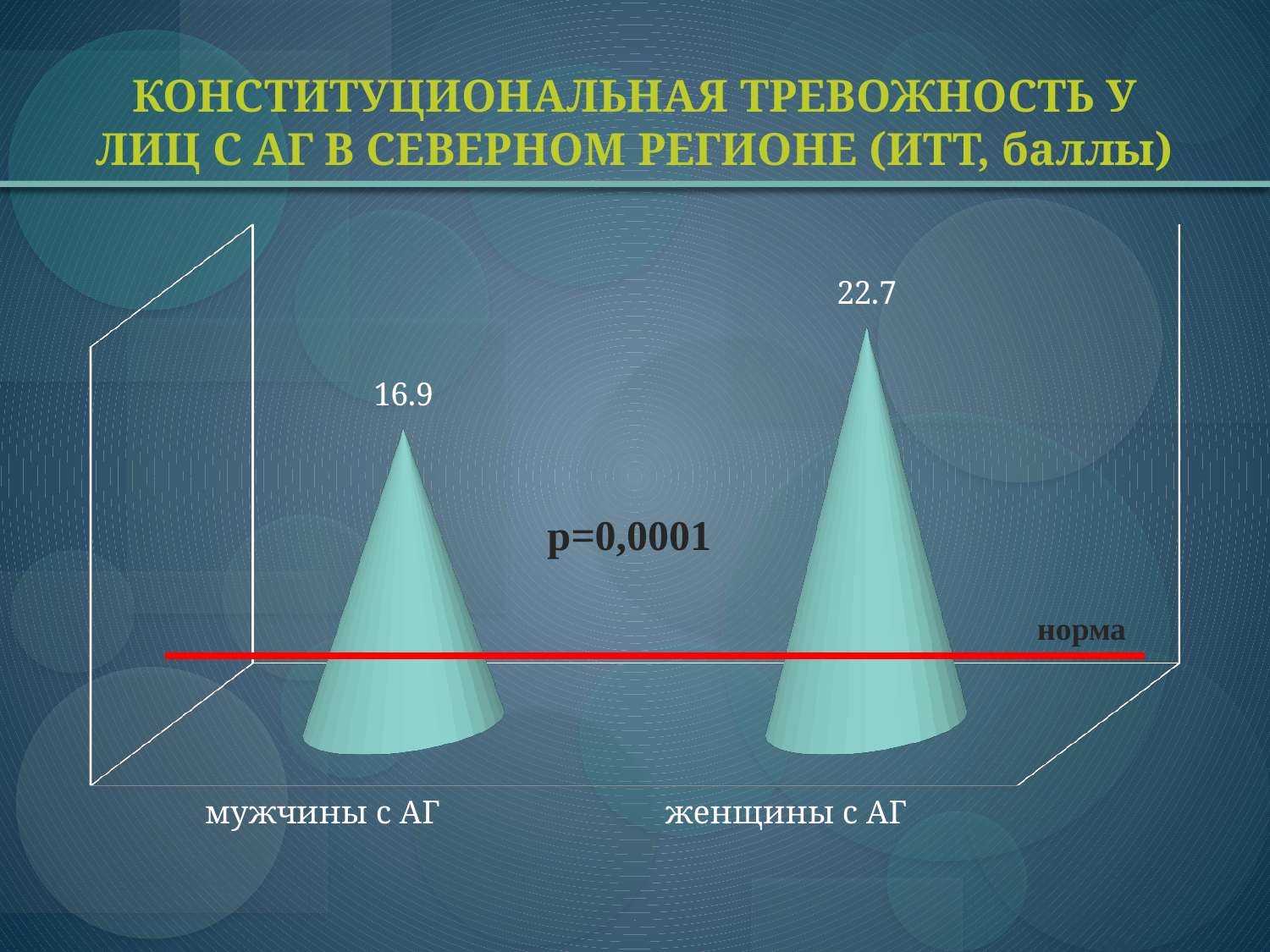
What is the p-value printed on the chart? p=0,0001 Which category has the lowest value? мужчины с АГ What is the value for женщины с АГ? 22.7 Which is larger, the value for мужчины с АГ or the value for женщины с АГ? женщины с АГ What does the red horizontal line on the chart represent? норма Which category has the highest value? женщины с АГ How many categories are shown in the chart? 2 What is the value for мужчины с АГ? 16.9 What is the difference between the values for женщины с АГ and мужчины с АГ? 5.8 What kind of chart is shown on the slide? bar chart